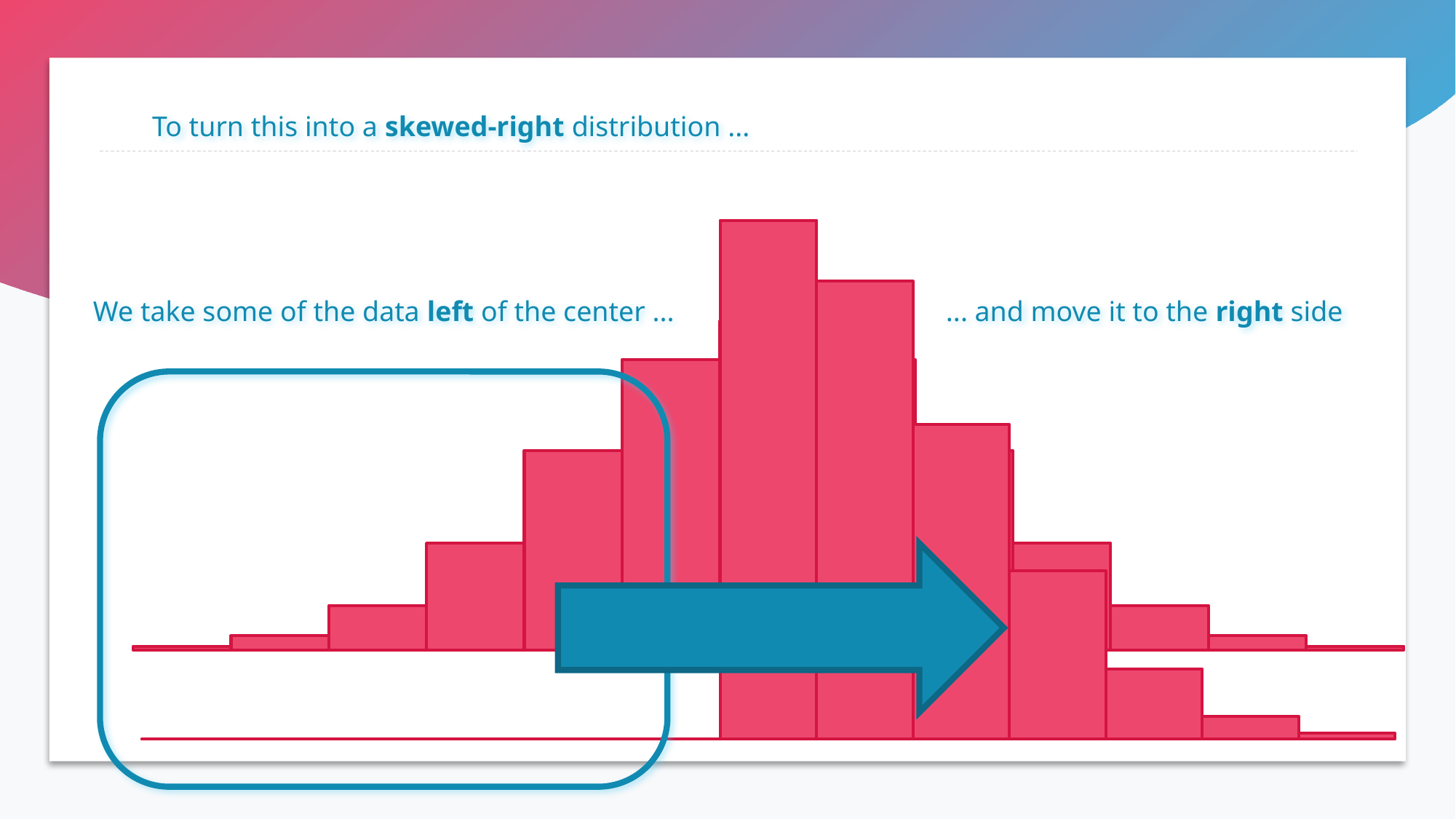
What colour are the bars in the chart? red What kind of chart is shown on the slide? bar chart According to the heading, what kind of distribution is the chart being turned into? skewed-right Where is the tallest bar of the chart located: on the left, in the center, or on the right? in the center